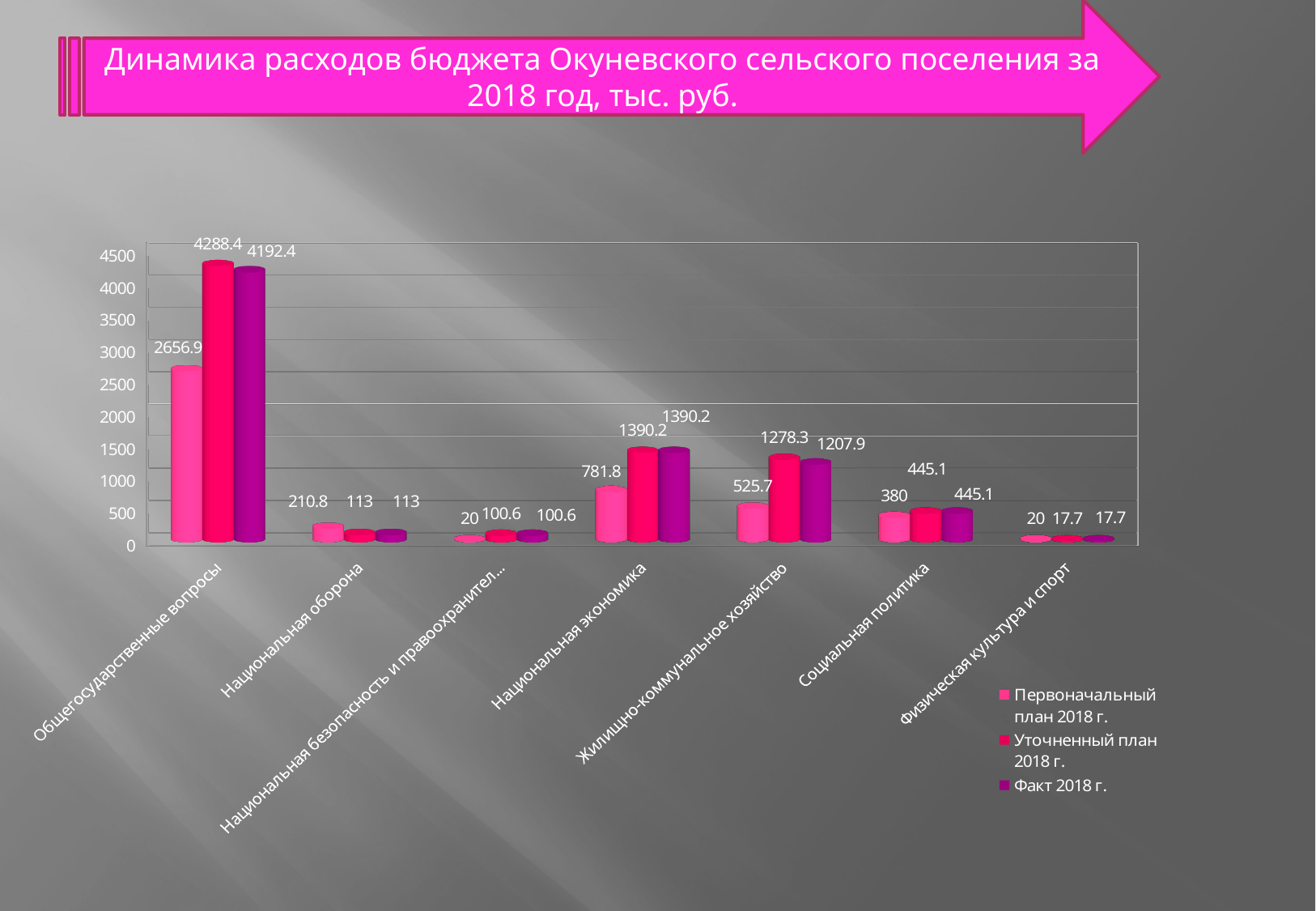
What is the value of Первоначальный план 2018 г. for Жилищно-коммунальное хозяйство? 525.7 What is the difference between Уточненный план 2018 г. and Первоначальный план 2018 г. for Общегосударственные вопросы? 1631.5 For Национальная оборона, which is larger: Первоначальный план 2018 г. or Факт 2018 г.? Первоначальный план 2018 г. What kind of chart is shown on the slide? Bar chart Which category has the highest value for Уточненный план 2018 г.? Общегосударственные вопросы What is the value of Факт 2018 г. for Общегосударственные вопросы? 4192.4 What is the value of Факт 2018 г. for Физическая культура и спорт? 17.7 What is the value of Уточненный план 2018 г. for Национальная экономика? 1390.2 What is the difference between Уточненный план 2018 г. and Факт 2018 г. for Жилищно-коммунальное хозяйство? 70.4 How many series does the legend list? 3 Which category has the lowest value for Факт 2018 г.? Физическая культура и спорт How many categories are shown on the x axis? 7